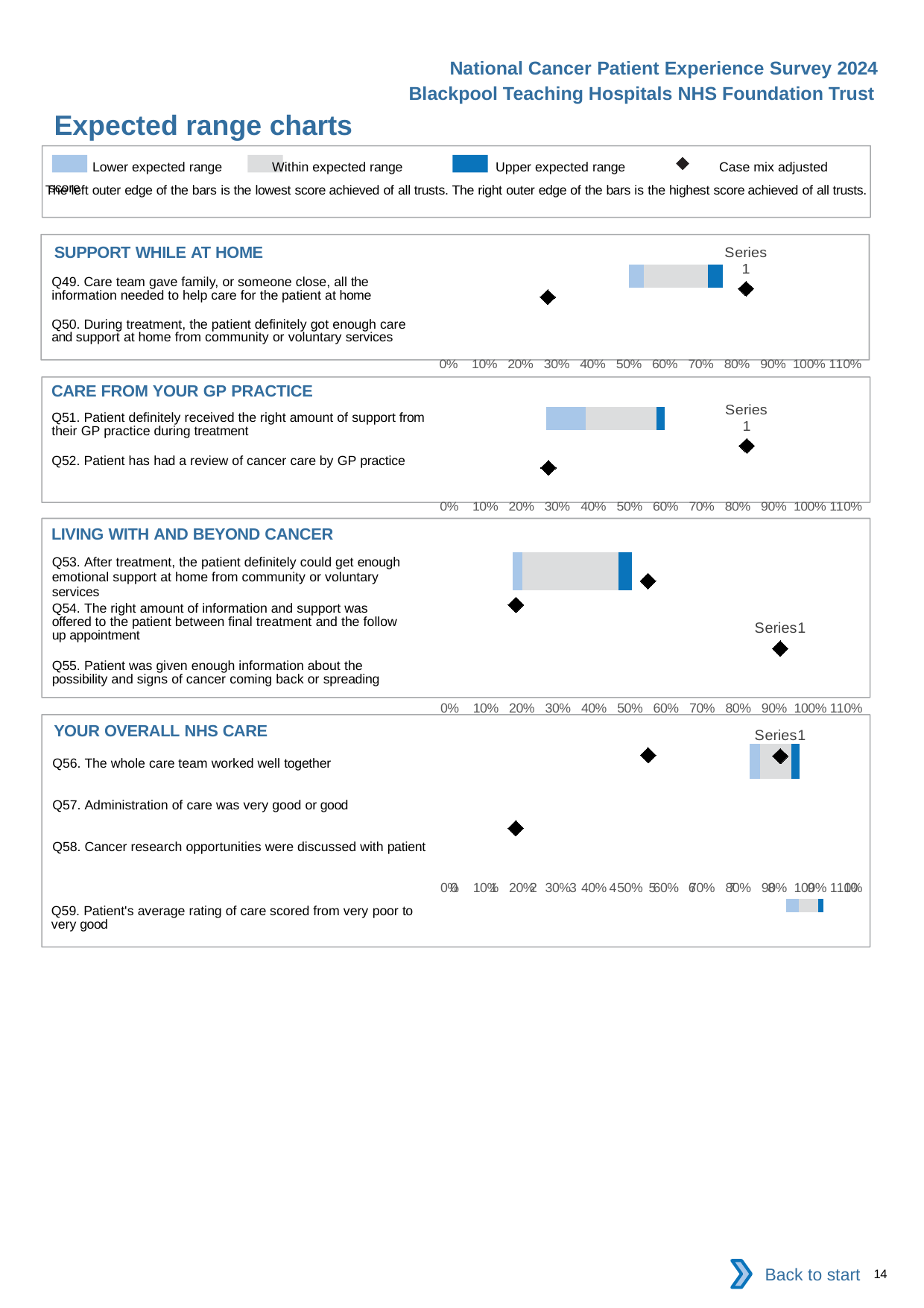
In the SUPPORT WHILE AT HOME chart, is the leftmost diamond marker greater or less than 40%? less In the LIVING WITH AND BEYOND CANCER chart, is the leftmost diamond marker greater or less than 30%? less How many questions are listed in the YOUR OVERALL NHS CARE section? 4 In the YOUR OVERALL NHS CARE chart, is the leftmost diamond marker greater or less than 30%? less What is the highest tick label shown on the x axis of the CARE FROM YOUR GP PRACTICE chart? 110% According to the legend, what does the black diamond marker represent? Case mix adjusted score How many questions are listed in the SUPPORT WHILE AT HOME section? 2 What kind of chart is used in the SUPPORT WHILE AT HOME section? bar chart How many expected range categories does the legend list (excluding the diamond marker)? 3 How many questions are listed in the LIVING WITH AND BEYOND CANCER section? 3